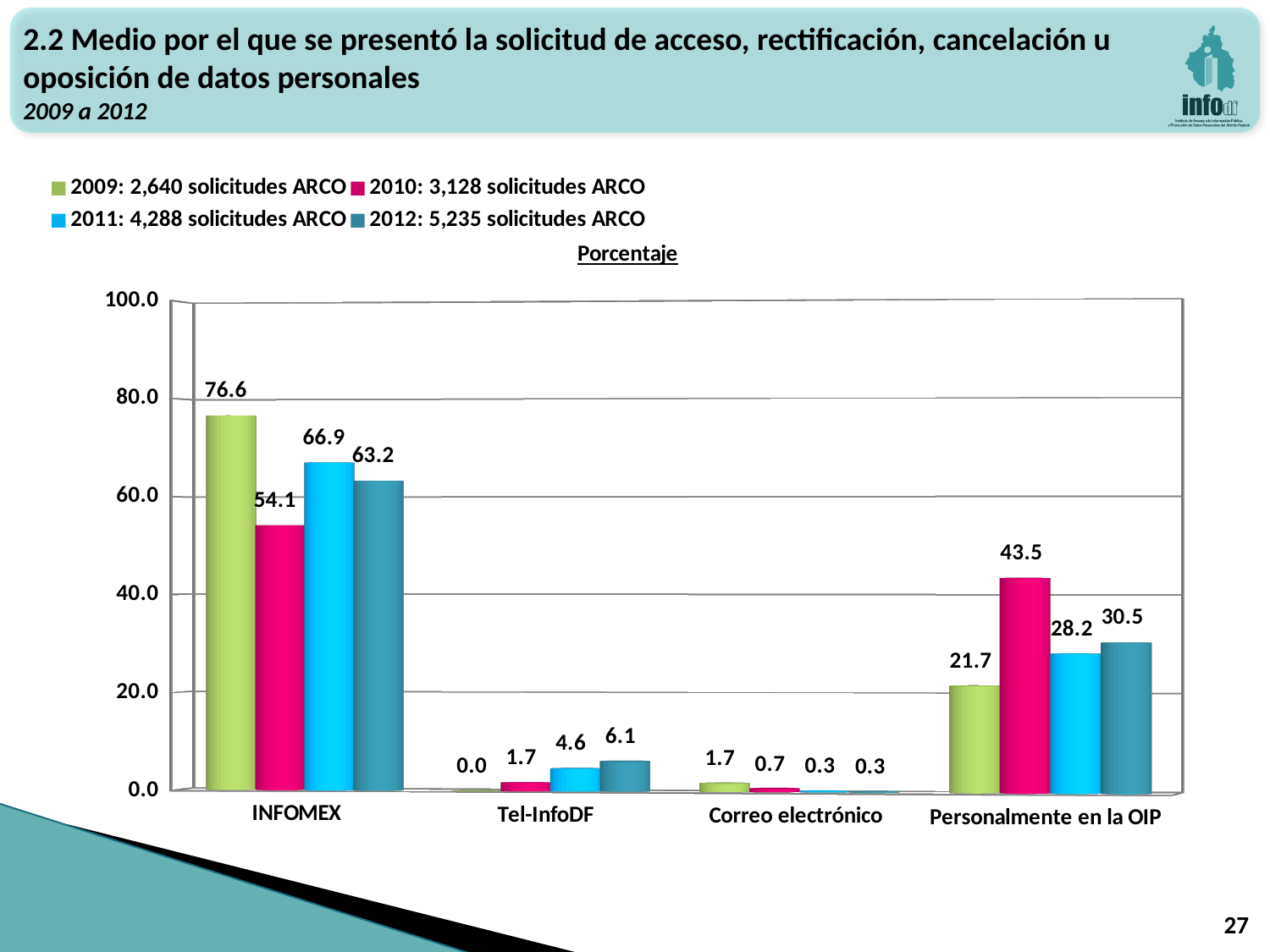
What is the value for INFOMEX in the 2009 series? 76.6 What is the difference between the 2009 and 2010 values for INFOMEX? 22.5 According to the legend, how many solicitudes ARCO were there in 2012? 5,235 Is the 2012 value for INFOMEX greater or less than 60.0? greater How many series does the legend list? 4 How many categories are shown on the x axis? 4 Which category has the lowest value in the 2009 series? Tel-InfoDF Which is larger for Personalmente en la OIP: the 2011 value or the 2012 value? 2012 What is the value for Tel-InfoDF in the 2012 series? 6.1 Which category has the highest value in the 2011 series? INFOMEX What kind of chart is shown on the slide? bar chart What is the value for Personalmente en la OIP in the 2010 series? 43.5